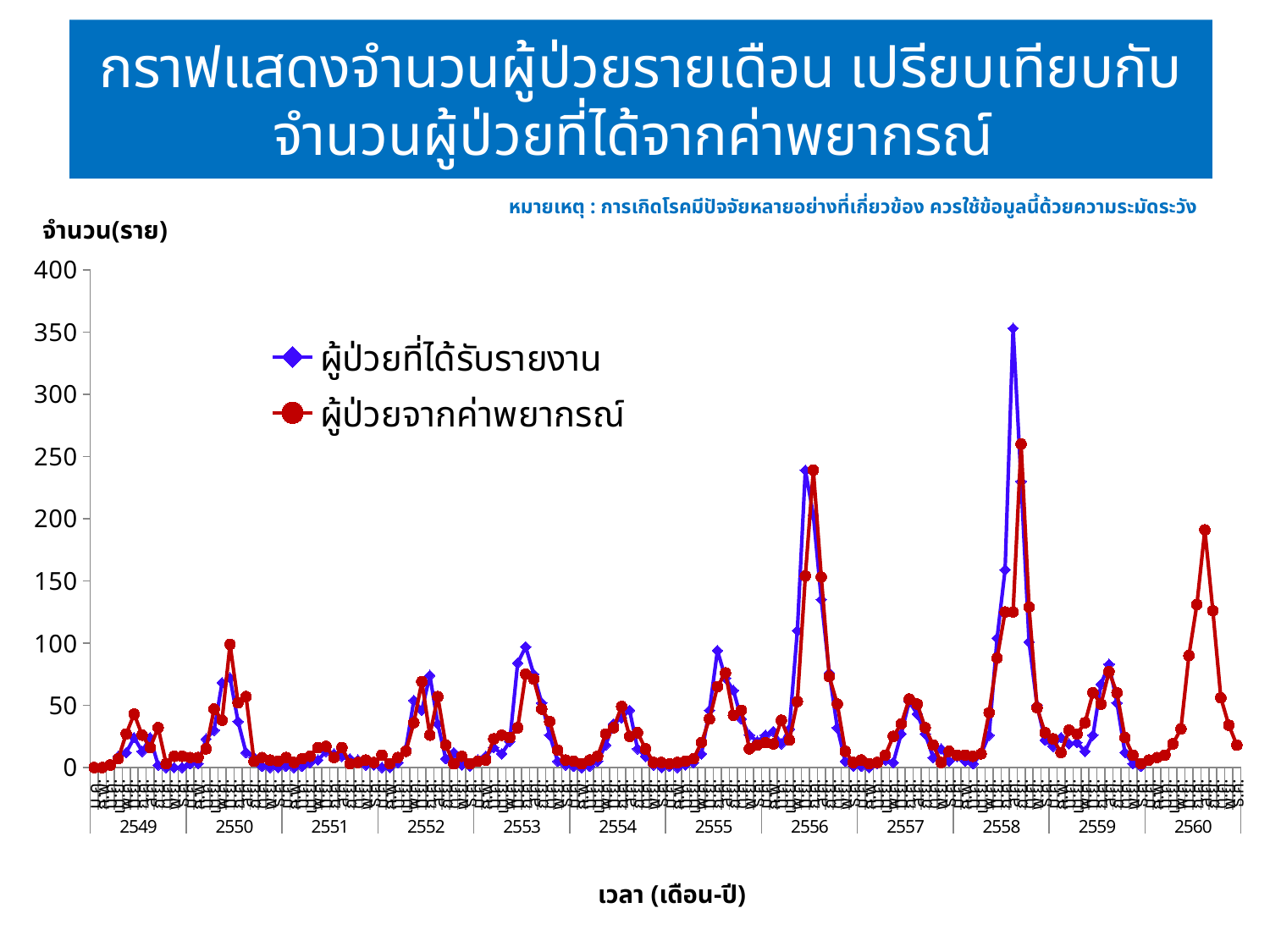
Is the peak of the ผู้ป่วยจากค่าพยากรณ์ series in 2550 greater or less than 150? less In which year does the ผู้ป่วยที่ได้รับรายงาน series reach its highest peak? 2558 How many series does the legend list? 2 What is the highest tick value shown on the vertical axis? 400 Is the peak of the ผู้ป่วยจากค่าพยากรณ์ series in 2560 greater or less than 150? greater How many year groups are labelled along the x axis? 12 Is the highest peak of the ผู้ป่วยที่ได้รับรายงาน series in 2558 greater or less than 300? greater At the 2558 peak, which series has the higher value, ผู้ป่วยที่ได้รับรายงาน or ผู้ป่วยจากค่าพยากรณ์? ผู้ป่วยที่ได้รับรายงาน What is the label on the vertical axis of the chart? จำนวน(ราย) Which series is drawn with blue diamond markers? ผู้ป่วยที่ได้รับรายงาน What kind of chart is shown on the slide? line chart For the ผู้ป่วยจากค่าพยากรณ์ series, which peak is higher, the one in 2560 or the one in 2550? 2560